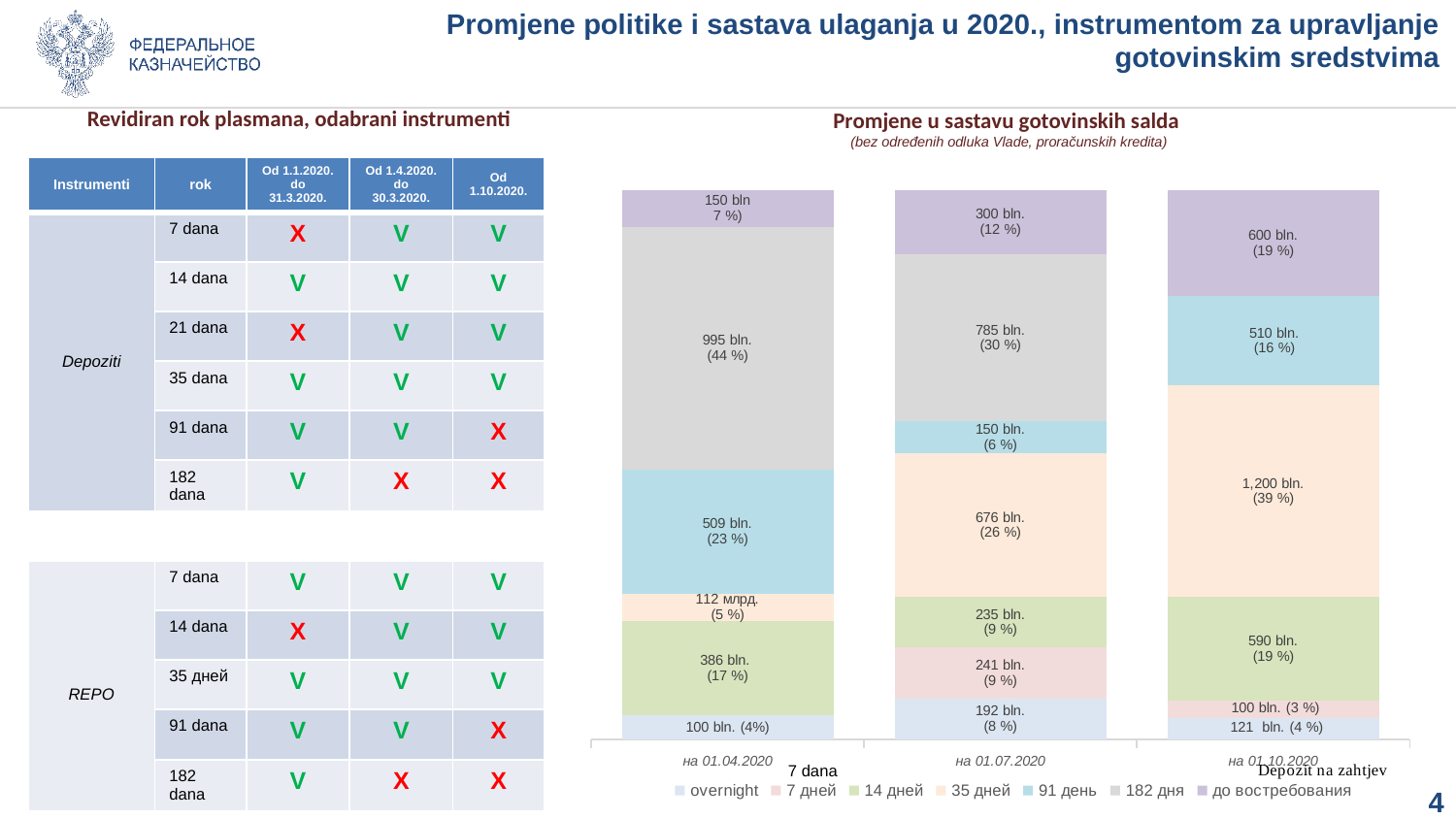
What kind of chart is shown under the title 'Promjene u sastavu gotovinskih salda'? stacked bar chart In the 'Promjene u sastavu gotovinskih salda' chart, which segment is the largest in the на 01.10.2020 bar? 35 дней In the 'Promjene u sastavu gotovinskih salda' chart, what is the value of the '182 дня' segment for на 01.04.2020? 995 bln. In the 'Promjene u sastavu gotovinskih salda' chart, what is the difference between the 'до востребования' values for на 01.10.2020 and на 01.04.2020? 450 bln. In the 'Promjene u sastavu gotovinskih salda' chart, what share of the на 01.07.2020 bar is the '182 дня' segment? 30 % In the 'Promjene u sastavu gotovinskih salda' chart, which is larger: the '91 день' segment for на 01.04.2020 or for на 01.07.2020? на 01.04.2020 In the 'Promjene u sastavu gotovinskih salda' chart, what is the total of the на 01.07.2020 bar? 2,579 bln. In the 'Promjene u sastavu gotovinskih salda' chart, which segment is the smallest in the на 01.04.2020 bar? overnight In the 'Promjene u sastavu gotovinskih salda' chart, what is the value of the '35 дней' segment for на 01.10.2020? 1,200 bln. In the 'Promjene u sastavu gotovinskih salda' chart, what is the value of the 'overnight' segment for на 01.07.2020? 192 bln. How many series does the legend of the 'Promjene u sastavu gotovinskih salda' chart list? 7 How many dates (bars) are shown on the x axis of the 'Promjene u sastavu gotovinskih salda' chart? 3